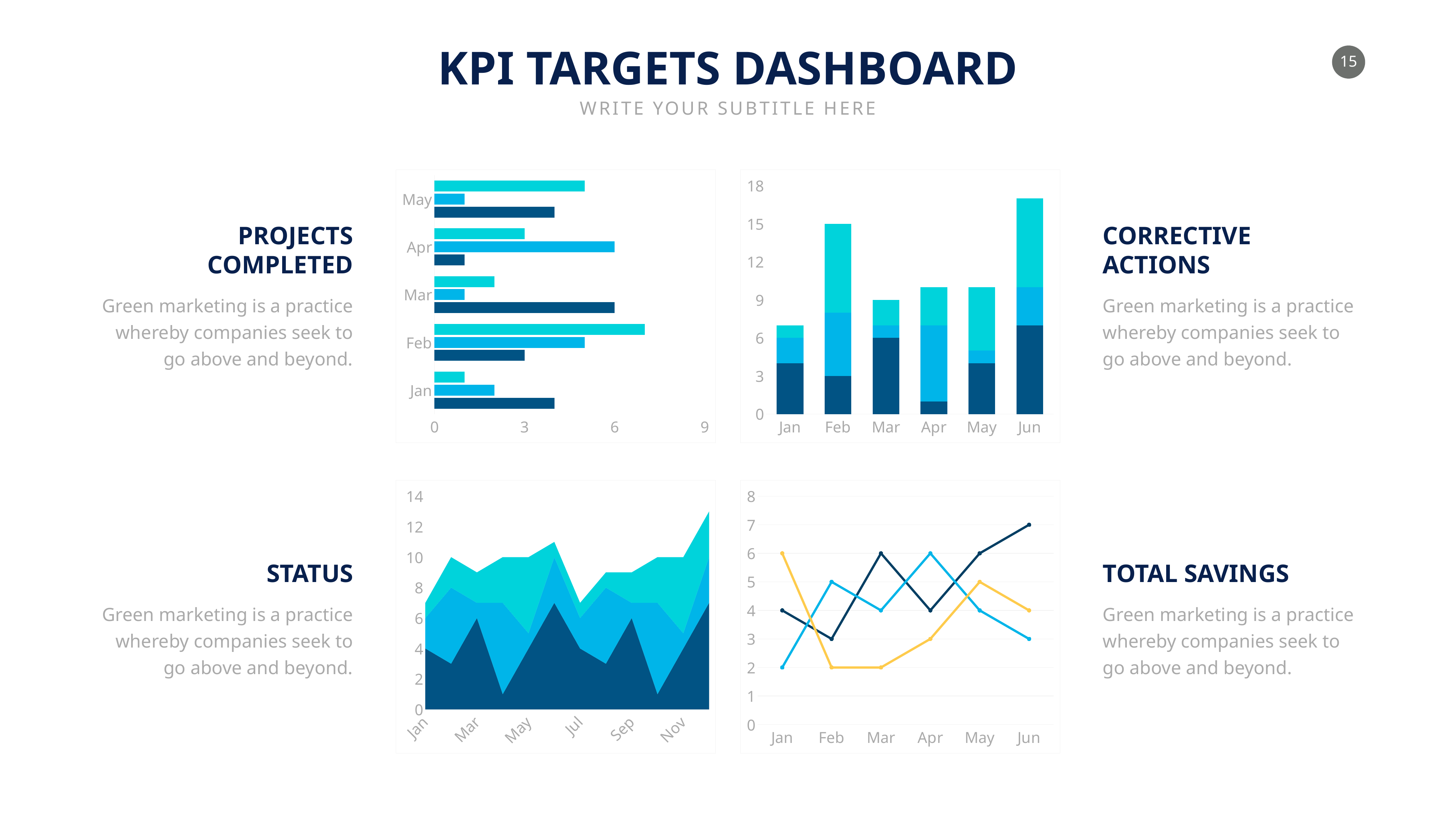
What type of chart is the Total Savings chart? line chart In the Corrective Actions chart, is the total for Jan greater or less than 9? less How many months are shown on the Projects Completed chart? 5 In the Corrective Actions chart, is the total for Jun greater or less than 15? greater What type of chart is the Projects Completed chart? bar chart In the Corrective Actions chart, which month has the tallest stacked bar? Jun In the Projects Completed chart, is the longest bar for Feb greater or less than 6? greater How many months are shown on the Corrective Actions chart? 6 What type of chart is the Corrective Actions chart? bar chart In the Corrective Actions chart, which month has the shortest stacked bar? Jan How many months are shown on the x axis of the Total Savings chart? 6